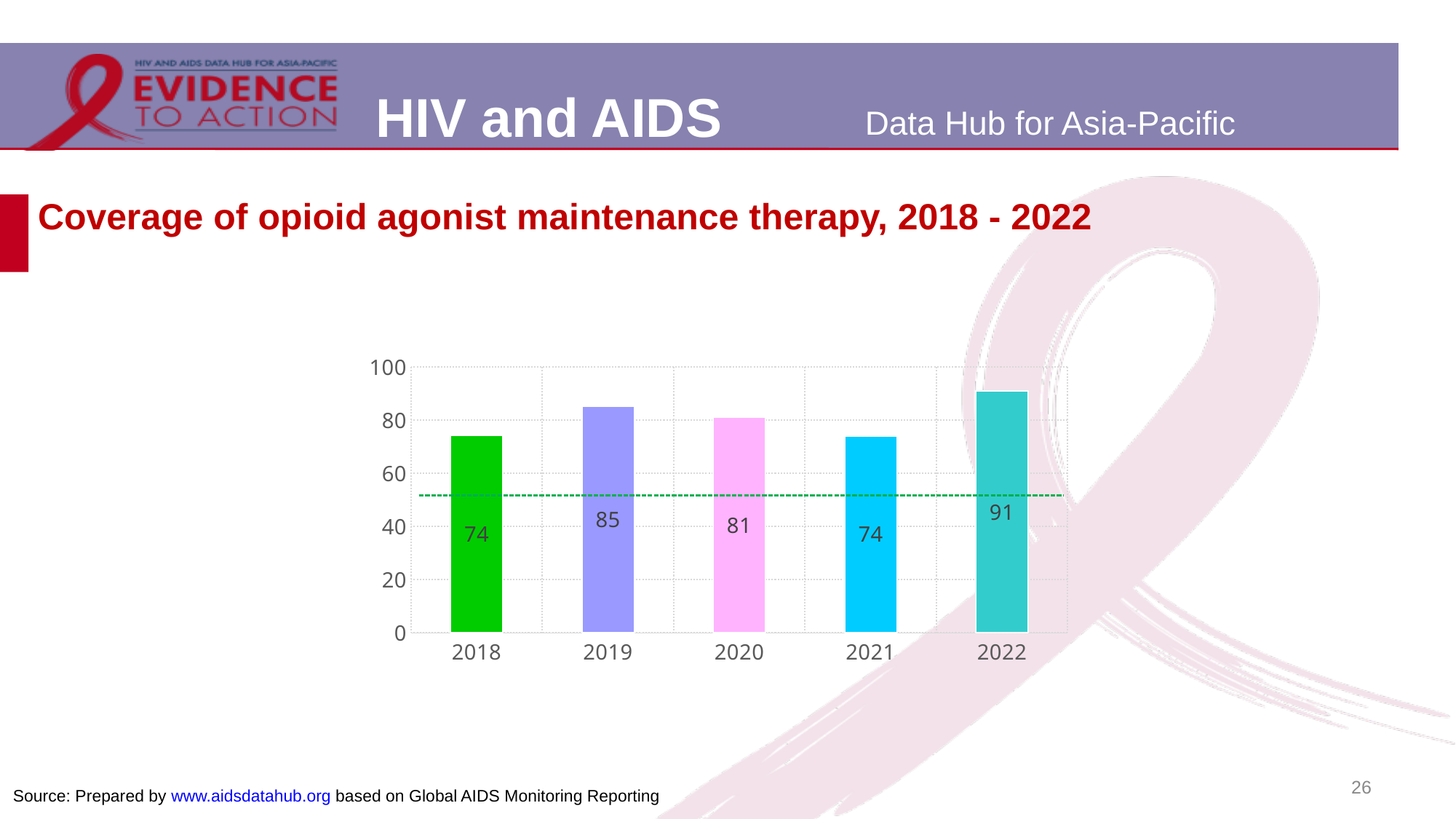
What kind of chart is shown on the slide? bar chart What is the difference between the values for 2022 and 2018? 17 What is the value for 2019? 85 What is the difference between the values for 2019 and 2021? 11 Which is larger, the value for 2019 or the value for 2020? 2019 How many years are shown on the x axis? 5 Is the value for 2021 greater or less than 80? less Did the value rise or fall from 2020 to 2021? fall What is the title of the chart? Coverage of opioid agonist maintenance therapy, 2018 - 2022 What is the value for 2020? 81 Which year has the highest value? 2022 What is the value for 2022? 91